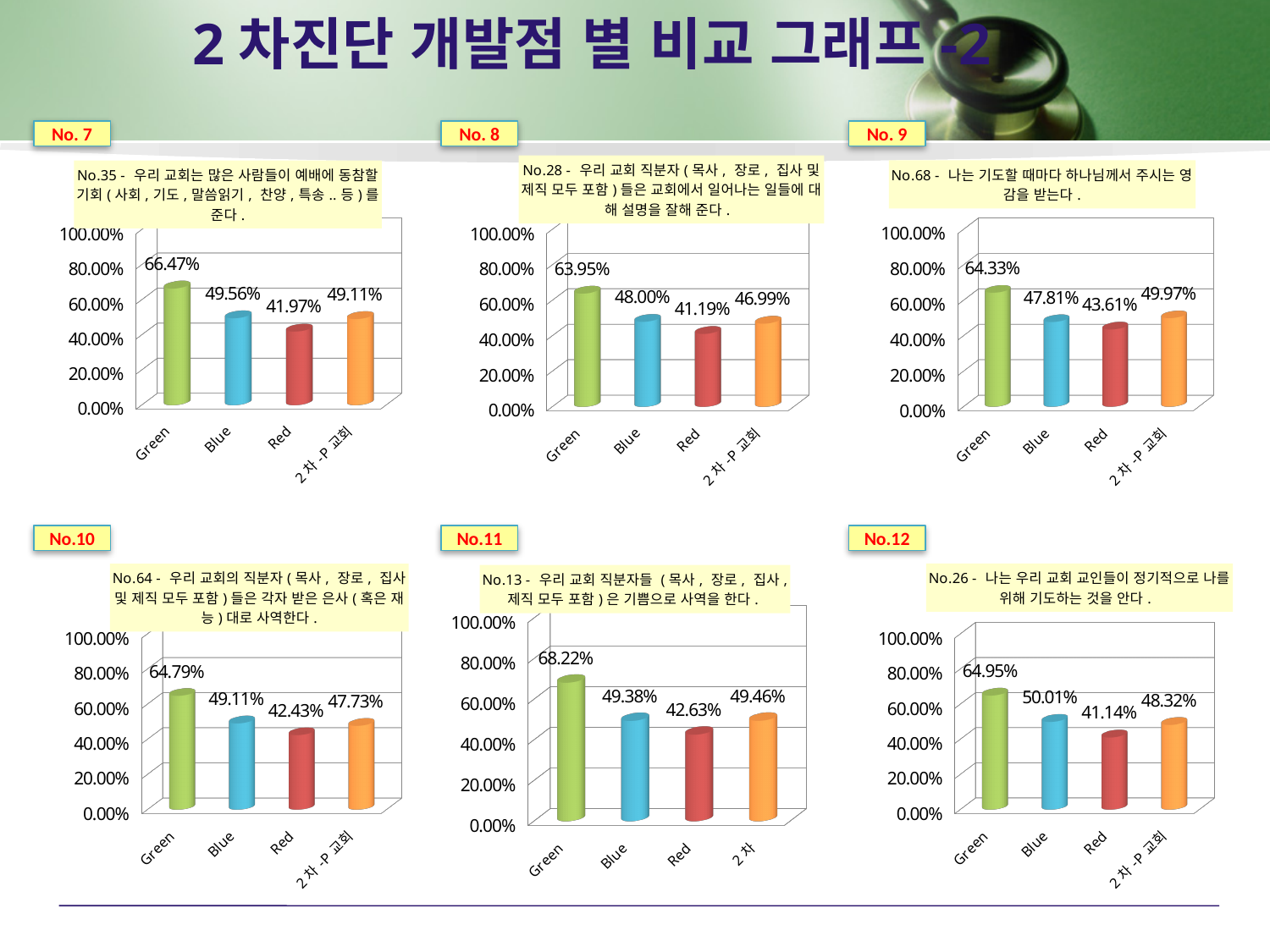
In the No. 8 chart, what is the value for Red? 41.19% What kind of chart is the No. 9 chart? Bar chart In the No.12 chart, what is the value for Blue? 50.01% In the No. 7 chart, what is the value for Green? 66.47% How many bars are plotted in the No.10 chart? 4 In the No.10 chart, which category has the lowest value? Red In the No.11 chart, which category has the highest value? Green In the No.12 chart, what is the difference between the Blue value and the Red value? 8.87% How many charts are shown on the slide? 6 In the No. 7 chart, what is the difference between the Green value and the Red value? 24.50% In the No. 8 chart, which is larger, the value for Blue or the value for Red? Blue In the No. 9 chart, what is the value for 2차-P 교회? 49.97%